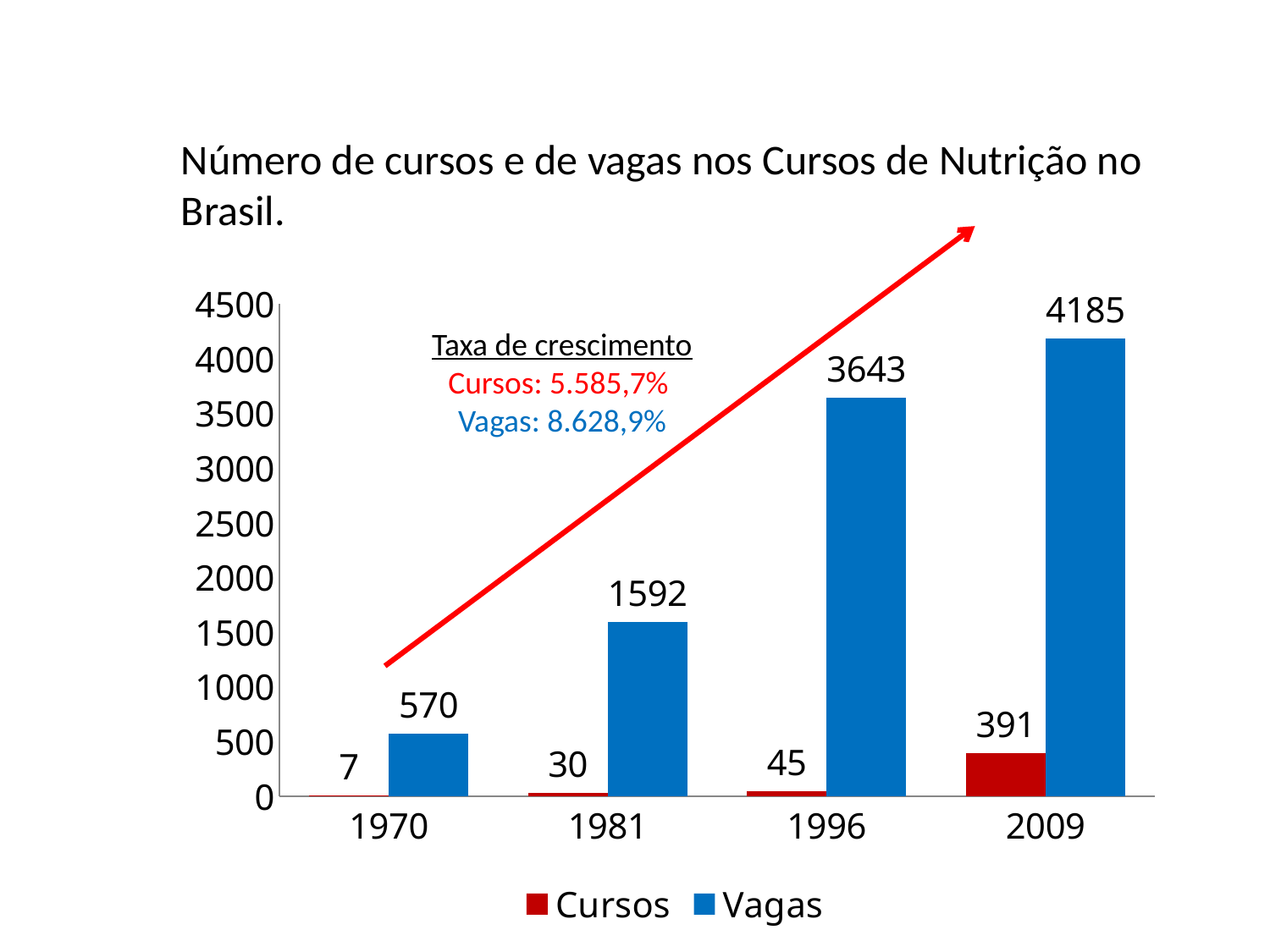
Which is larger, Vagas in 1981 or Vagas in 1996? Vagas in 1996 How many series does the legend list? 2 Is the value for Vagas in 1996 greater or less than 3500? greater What is the difference between the Cursos values for 2009 and 1996? 346 In which year is the Vagas value lowest? 1970 What is the value of Vagas in 2009? 4185 What is the value of Cursos in 1981? 30 What is the value of Vagas in 1970? 570 In which year is the Cursos value highest? 2009 What is the difference between the Vagas values for 2009 and 1996? 542 What kind of chart is shown on the slide? bar chart How many years are shown on the x axis? 4